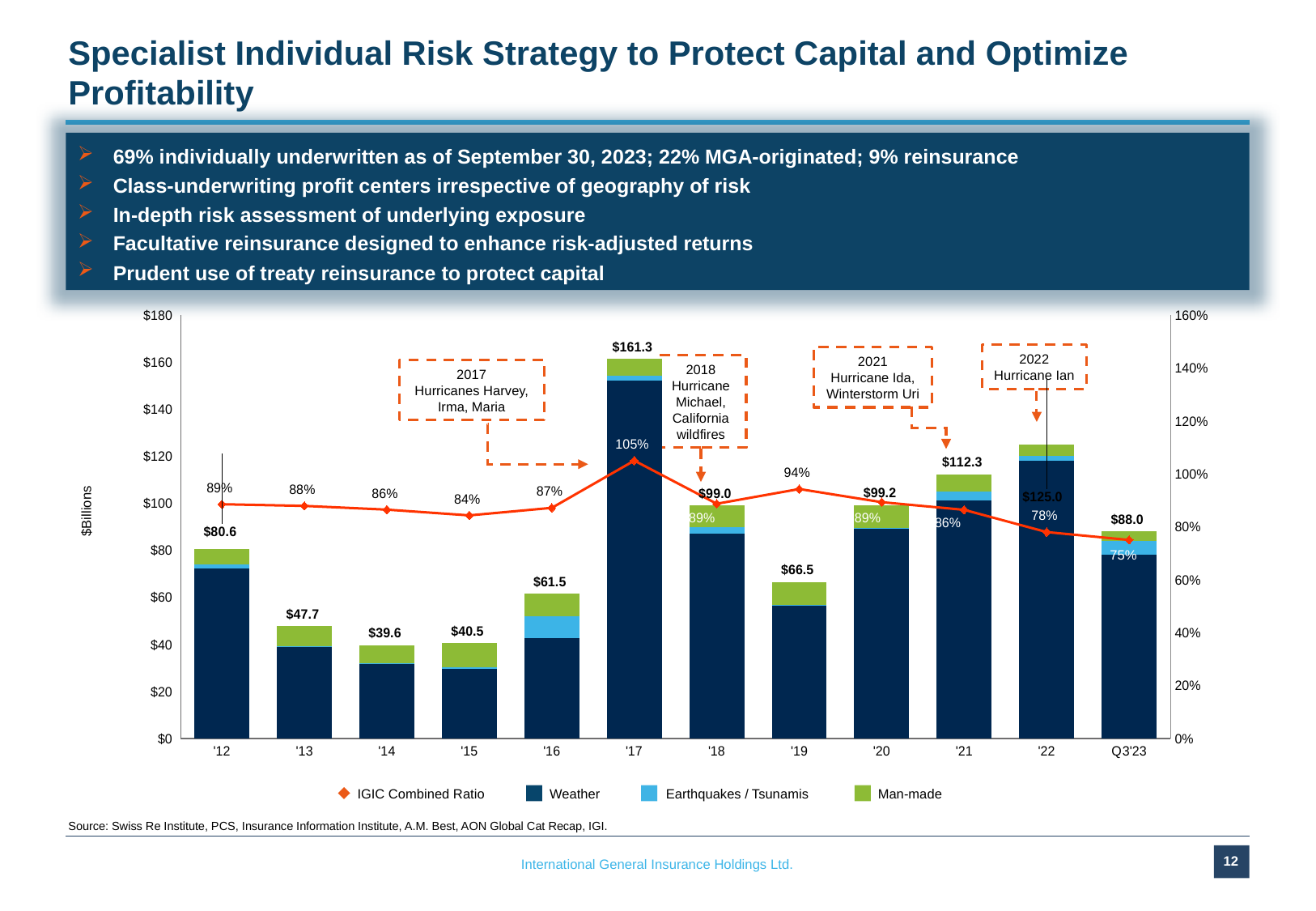
Which year has the highest total bar value? '17 What is the IGIC Combined Ratio shown for '19? 94% Which year has the lowest total bar value? '14 What is the total bar value labeled for Q3'23? $88.0 What is the total insured catastrophe loss value labeled for '17? $161.3 In which year is the IGIC Combined Ratio highest? '17 Which year has a larger total bar value, '21 or '22? '22 How many time periods are shown on the x axis? 12 What is the difference between the total bar values for '17 and '18? $62.3 Does the IGIC Combined Ratio rise or fall from '19 to Q3'23? fall Is the Weather segment for '17 greater or less than $140? greater How many series does the legend list? 4